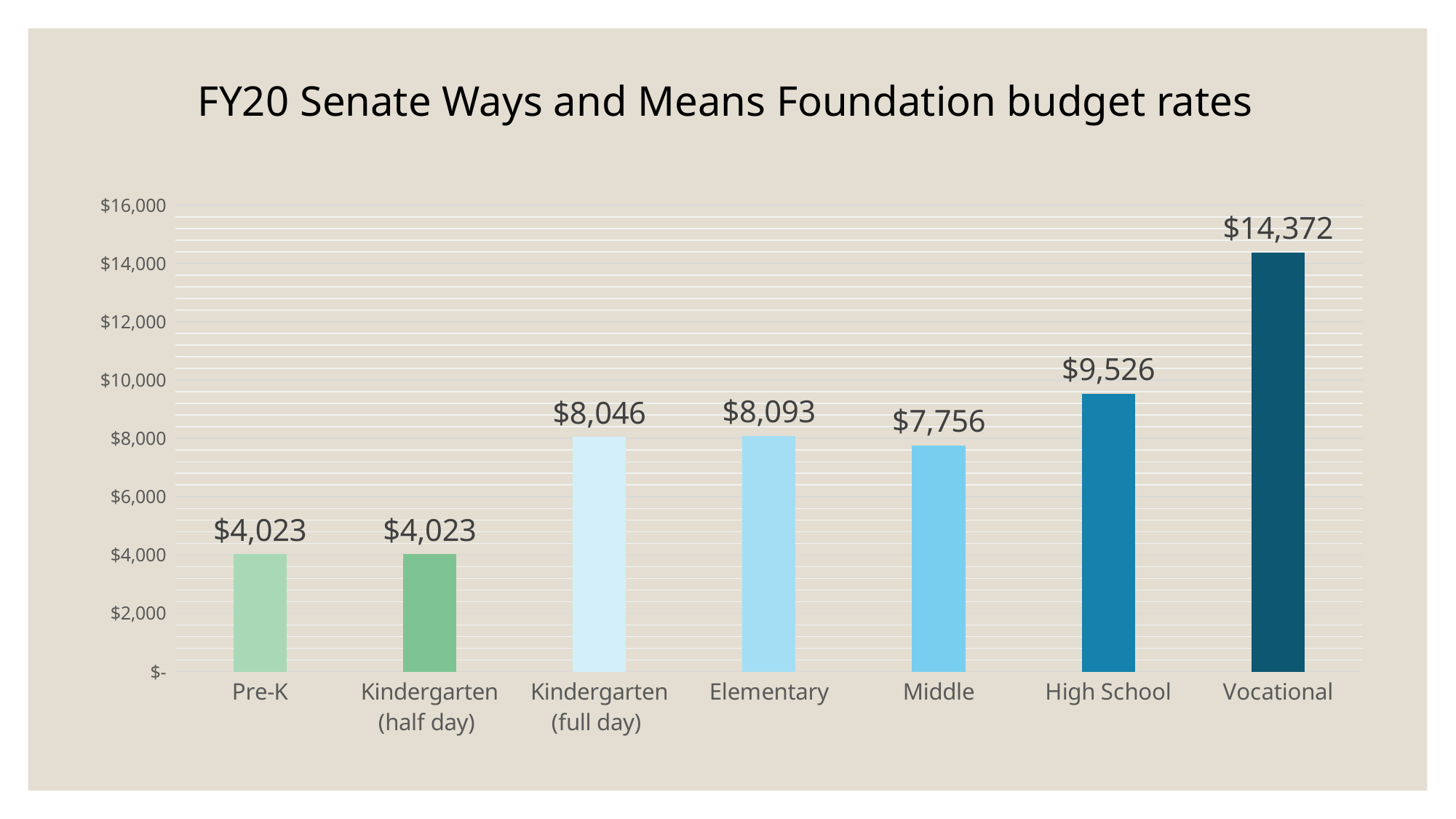
What is the foundation budget rate for Kindergarten (full day)? $8,046 What is the difference between the High School rate and the Middle rate? $1,770 What is the foundation budget rate for Vocational? $14,372 Which category has the highest foundation budget rate? Vocational What is the foundation budget rate for Middle? $7,756 What is the foundation budget rate for Pre-K? $4,023 What is the title of the chart? FY20 Senate Ways and Means Foundation budget rates Is the value for High School greater or less than $10,000? less What is the difference between the Vocational rate and the High School rate? $4,846 How many categories are shown on the x axis? 7 Which is larger, the rate for Elementary or the rate for Middle? Elementary What kind of chart is shown on the slide? bar chart